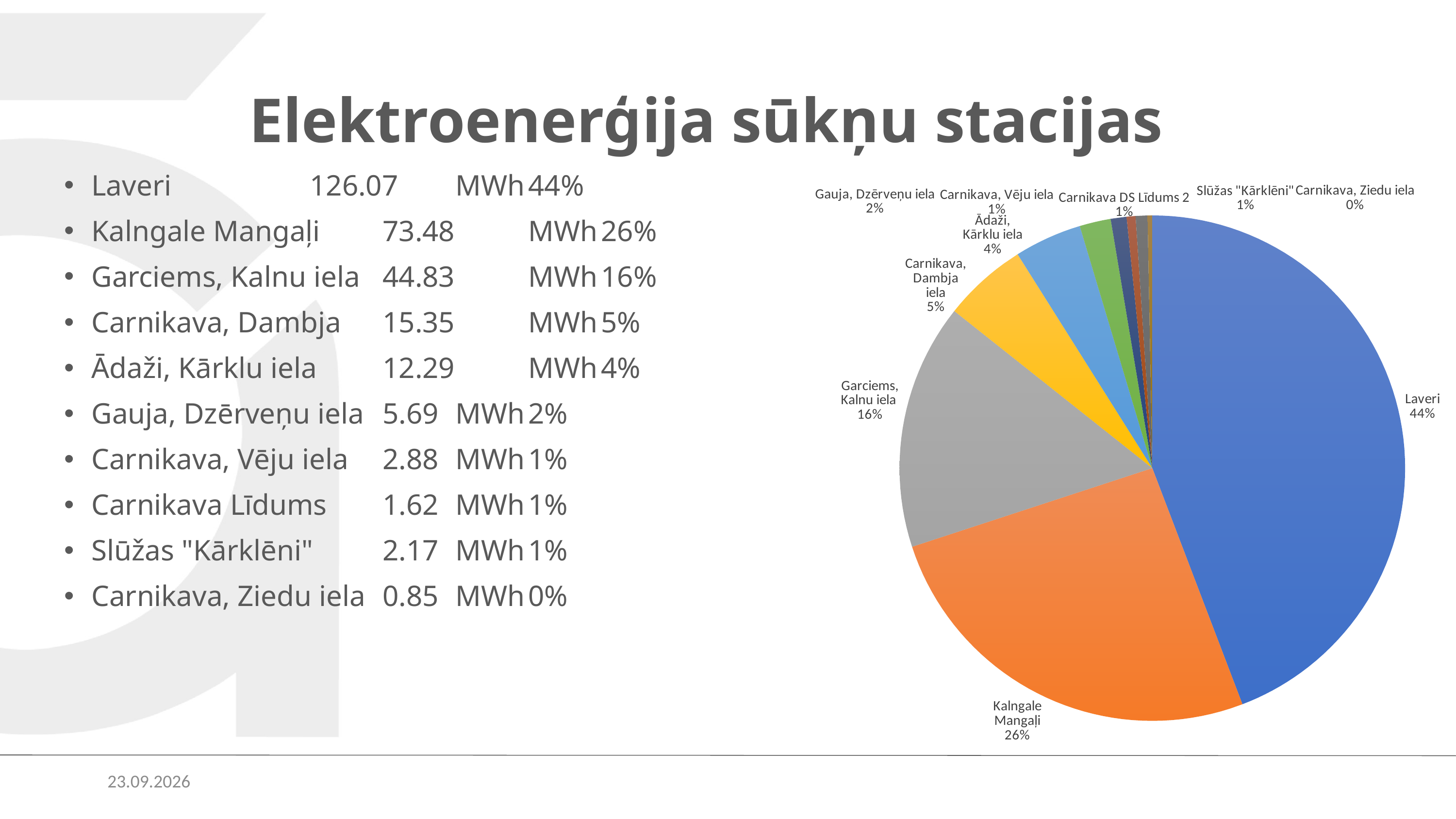
Which has a larger share of the pie, Kalngale Mangaļi or Garciems, Kalnu iela? Kalngale Mangaļi What percentage is shown for Gauja, Dzērveņu iela in the pie chart? 2% How many slices does the pie chart have? 10 What share of the pie does Kalngale Mangaļi account for? 26% Which slice of the pie chart is the largest? Laveri What percentage is shown for Ādaži, Kārklu iela in the pie chart? 4% By how many percentage points does Laveri's share exceed Kalngale Mangaļi's share? 18 percentage points What share of the pie does Laveri account for? 44% What kind of chart is shown on the slide? pie chart What share of the pie does Garciems, Kalnu iela account for? 16% Which slice of the pie chart is the smallest? Carnikava, Ziedu iela What percentage is shown for Carnikava, Dambja iela in the pie chart? 5%